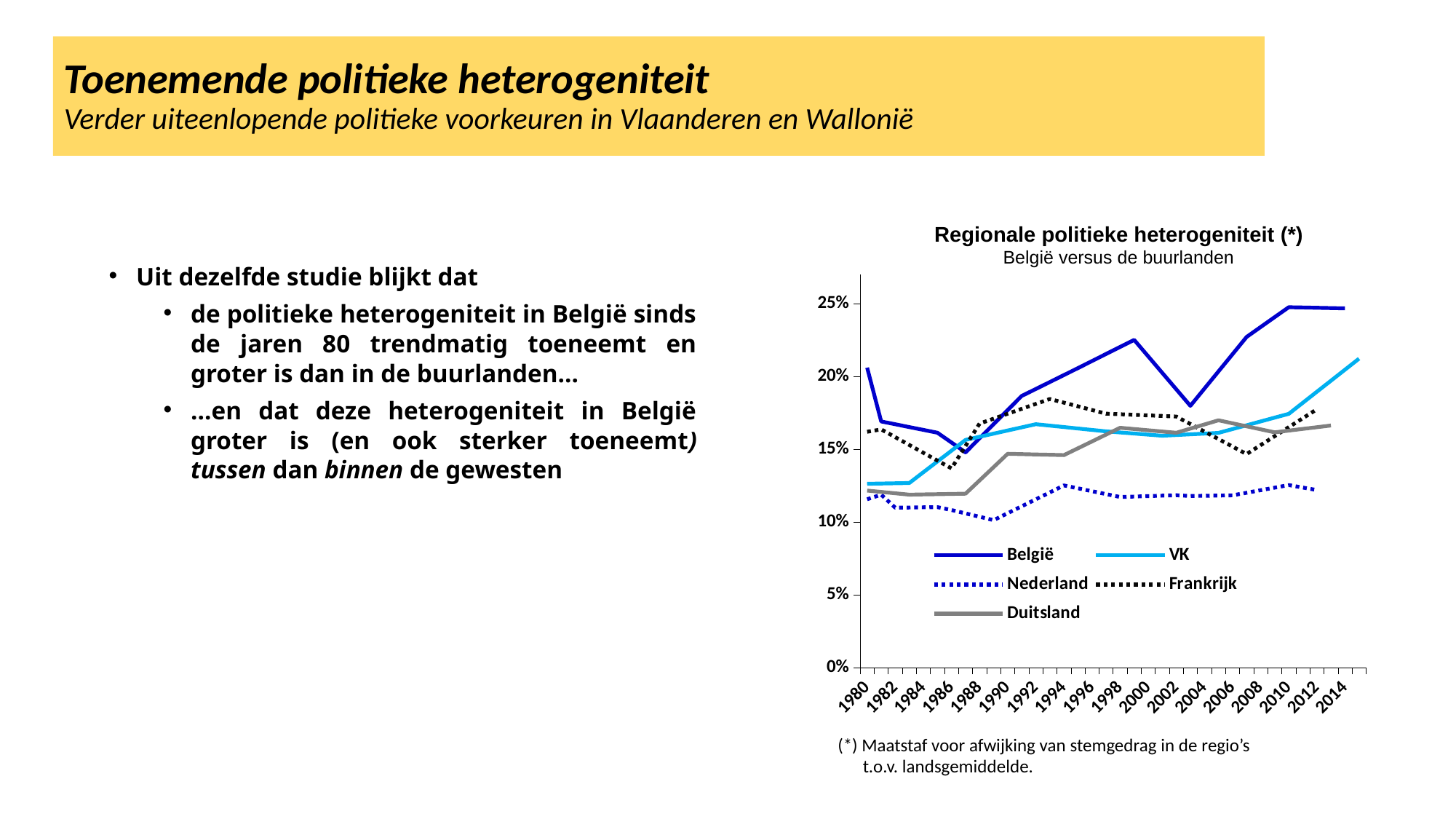
Is the value for Nederland in 1990 greater or less than 15%? less Which series has the highest value in 2010? België What kind of chart is shown on the slide? line chart Does the value for VK rise or fall between 2004 and 2014? rise Which series is plotted with a solid grey line? Duitsland How many series does the legend of the chart list? 5 Is the value for België in 2010 greater or less than 20%? greater Which series has the lowest value in 2000? Nederland Is the value for Duitsland in 1980 greater or less than 15%? less What is the title of the chart? Regionale politieke heterogeniteit (*)